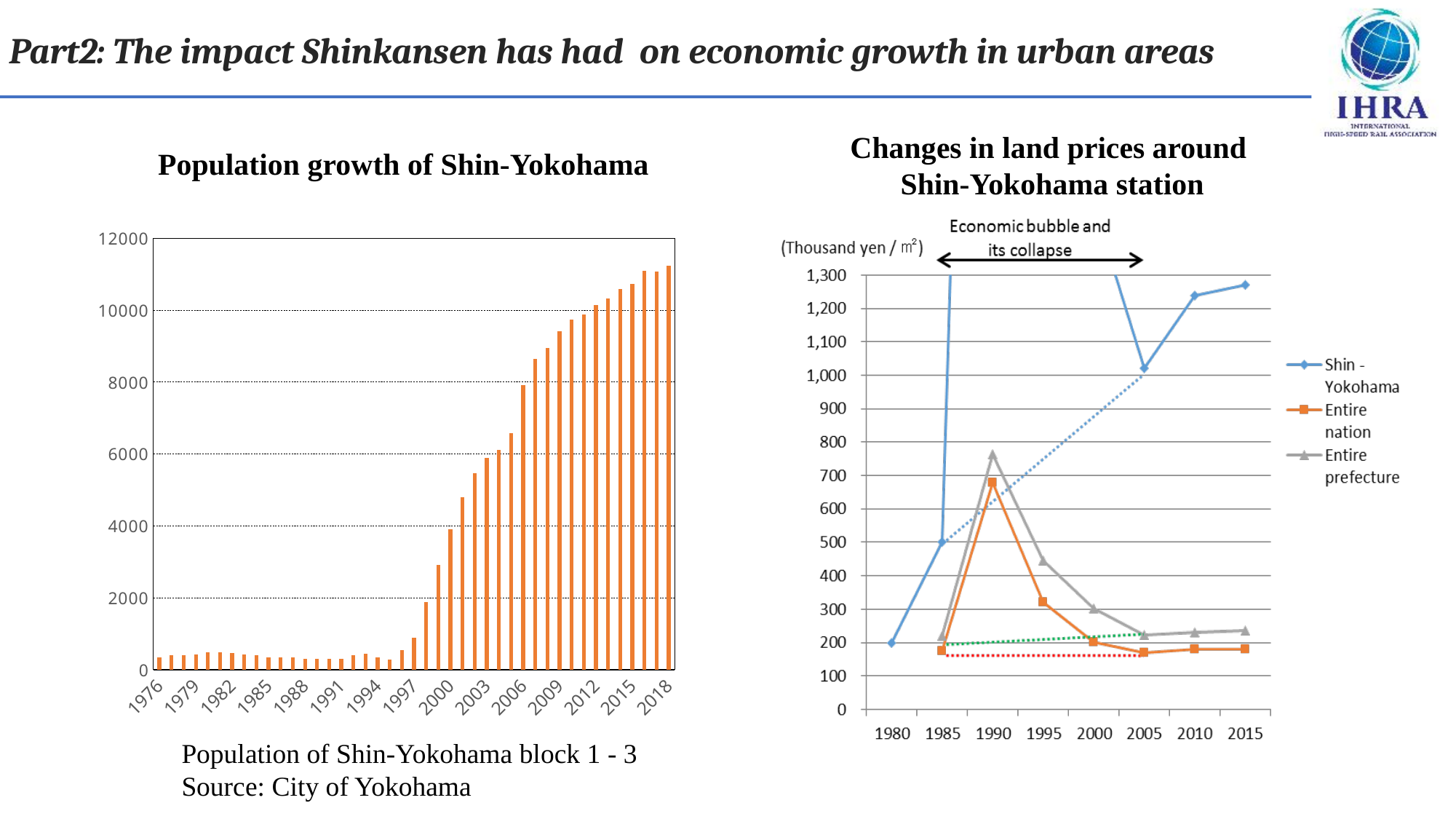
What kind of chart is the 'Changes in land prices around Shin-Yokohama station' chart? line chart In the 'Population growth of Shin-Yokohama' chart, is the value for 1976 greater or less than 2000? less In the 'Changes in land prices around Shin-Yokohama station' chart, is the Entire nation value for 2005 greater or less than 200? less How many series does the legend of the 'Changes in land prices around Shin-Yokohama station' chart list? 3 What unit is shown on the y axis of the 'Changes in land prices around Shin-Yokohama station' chart? Thousand yen / m² In the 'Population growth of Shin-Yokohama' chart, is the value for 2018 greater or less than 10000? greater In the 'Population growth of Shin-Yokohama' chart, do the values generally rise or fall from 1997 to 2018? rise In the 'Changes in land prices around Shin-Yokohama station' chart, which series has the higher value in 1990: Entire nation or Entire prefecture? Entire prefecture In the 'Changes in land prices around Shin-Yokohama station' chart, in which year does the Entire nation series reach its highest value? 1990 What kind of chart is the 'Population growth of Shin-Yokohama' chart? bar chart